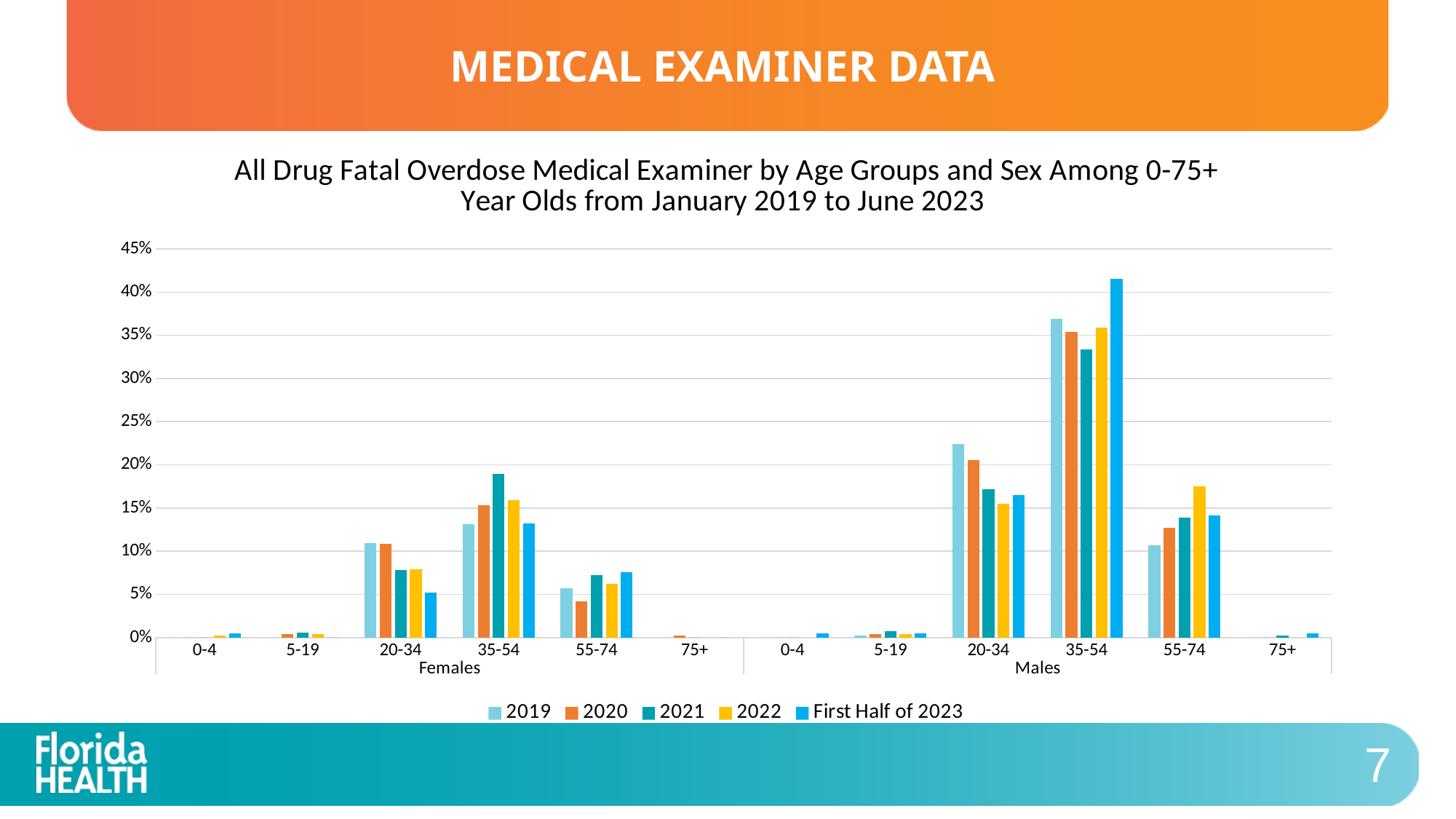
For Males 20-34, which is larger: the 2019 value or the 2020 value? 2019 Is the value for Females 35-54 in 2021 greater or less than 15%? greater For Females 20-34, which is larger: the 2019 value or the First Half of 2023 value? 2019 Is the value for Females 55-74 in 2020 greater or less than 5%? less Is the value for Males 35-54 in First Half of 2023 greater or less than 40%? greater What kind of chart is shown on the slide? bar chart How many series does the legend list? 5 How many age groups are shown for Females on the x axis? 6 Which sex and age group has the tallest bar in the chart? Males 35-54 Within the Females 35-54 age group, which series has the highest value? 2021 Within the Males 55-74 age group, which series has the highest value? 2022